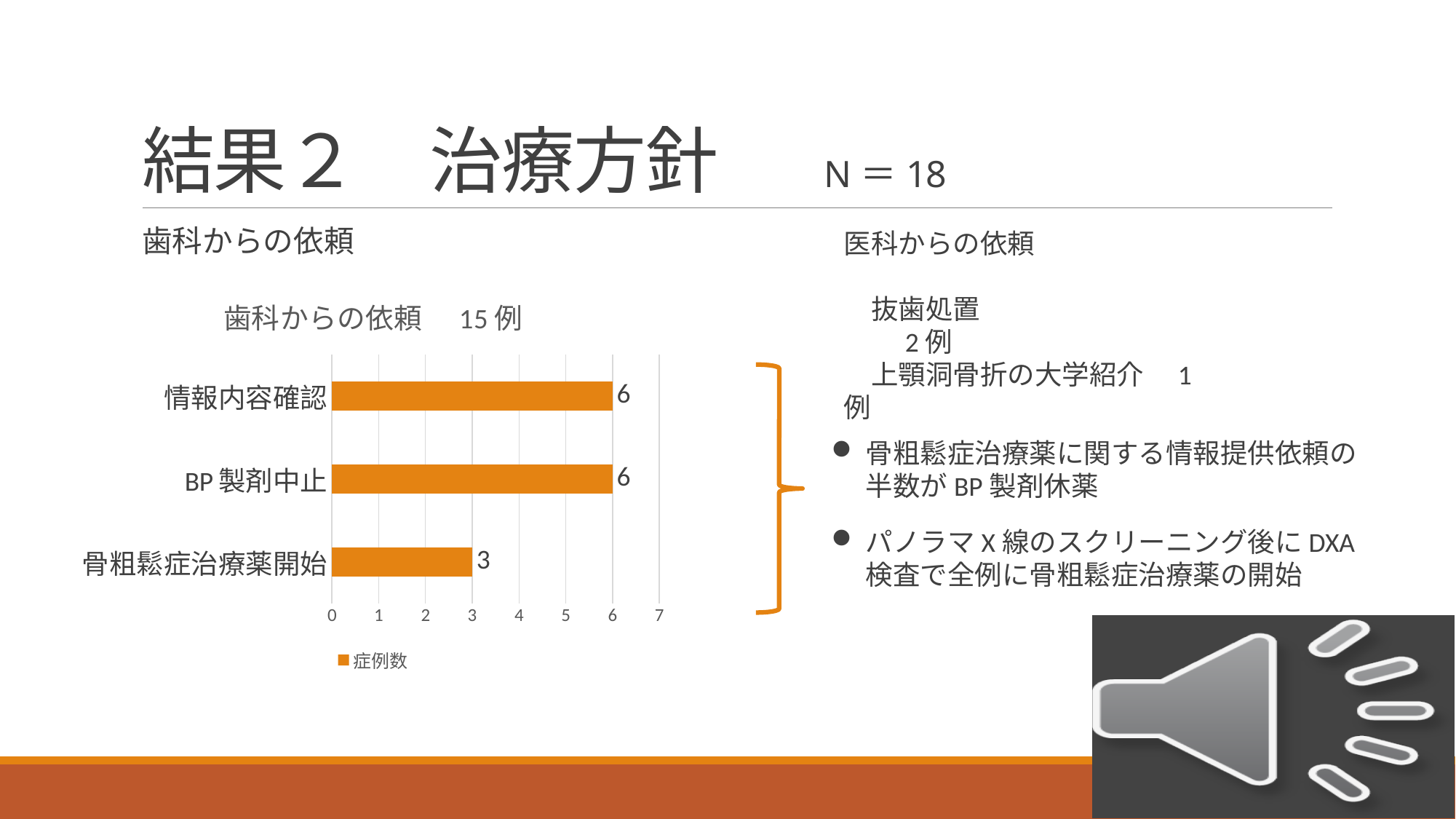
Is the value for 骨粗鬆症治療薬開始 greater or less than 5? less Which is larger, the value for BP製剤中止 or the value for 骨粗鬆症治療薬開始? BP製剤中止 What kind of chart is shown on the slide? bar chart What is the value for 情報内容確認? 6 How many categories are shown in the chart? 3 Which category has the lowest value? 骨粗鬆症治療薬開始 What is the legend entry of the chart? 症例数 What is the difference between the values for 情報内容確認 and 骨粗鬆症治療薬開始? 3 What is the value for BP製剤中止? 6 What is the title of the chart? 歯科からの依頼 15例 How many series does the legend list? 1 What is the value for 骨粗鬆症治療薬開始? 3